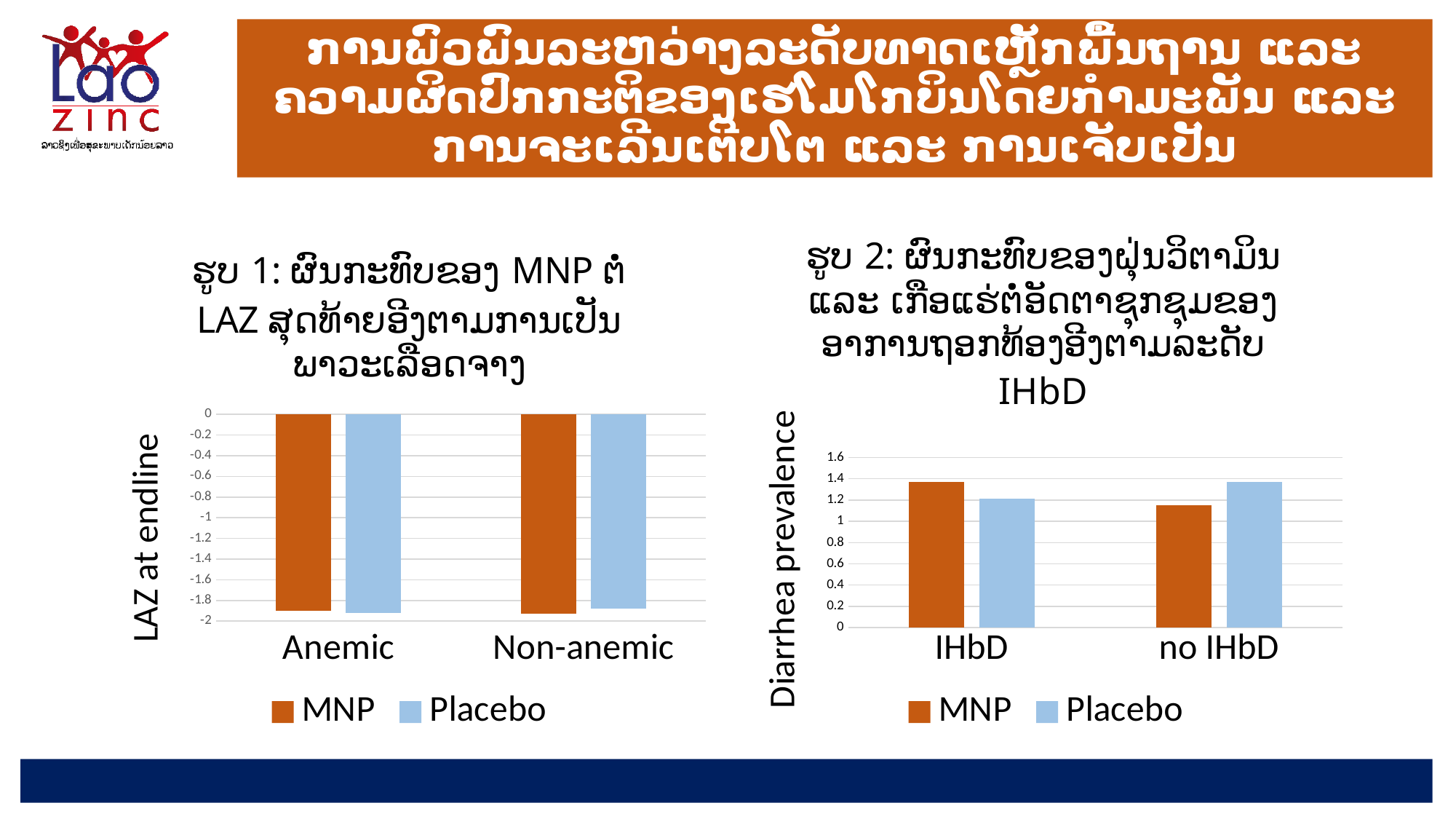
How many categories are shown on the x axis of the right chart (Diarrhea prevalence)? 2 What kind of chart is the left chart (LAZ at endline)? bar chart How many categories are shown on the x axis of the left chart (LAZ at endline)? 2 What are the two legend entries of the right chart (Diarrhea prevalence)? MNP and Placebo What is the y-axis title of the left chart? LAZ at endline In the right chart (Diarrhea prevalence), which series has the larger value for IHbD, MNP or Placebo? MNP In the right chart (Diarrhea prevalence), which series has the larger value for no IHbD, MNP or Placebo? Placebo In the left chart (LAZ at endline), is the Placebo value for Non-anemic greater or less than -1.5? less In the left chart (LAZ at endline), is the MNP value for Anemic greater or less than -1? less What kind of chart is the right chart (Diarrhea prevalence)? bar chart How many series does the legend of the left chart (LAZ at endline) list? 2